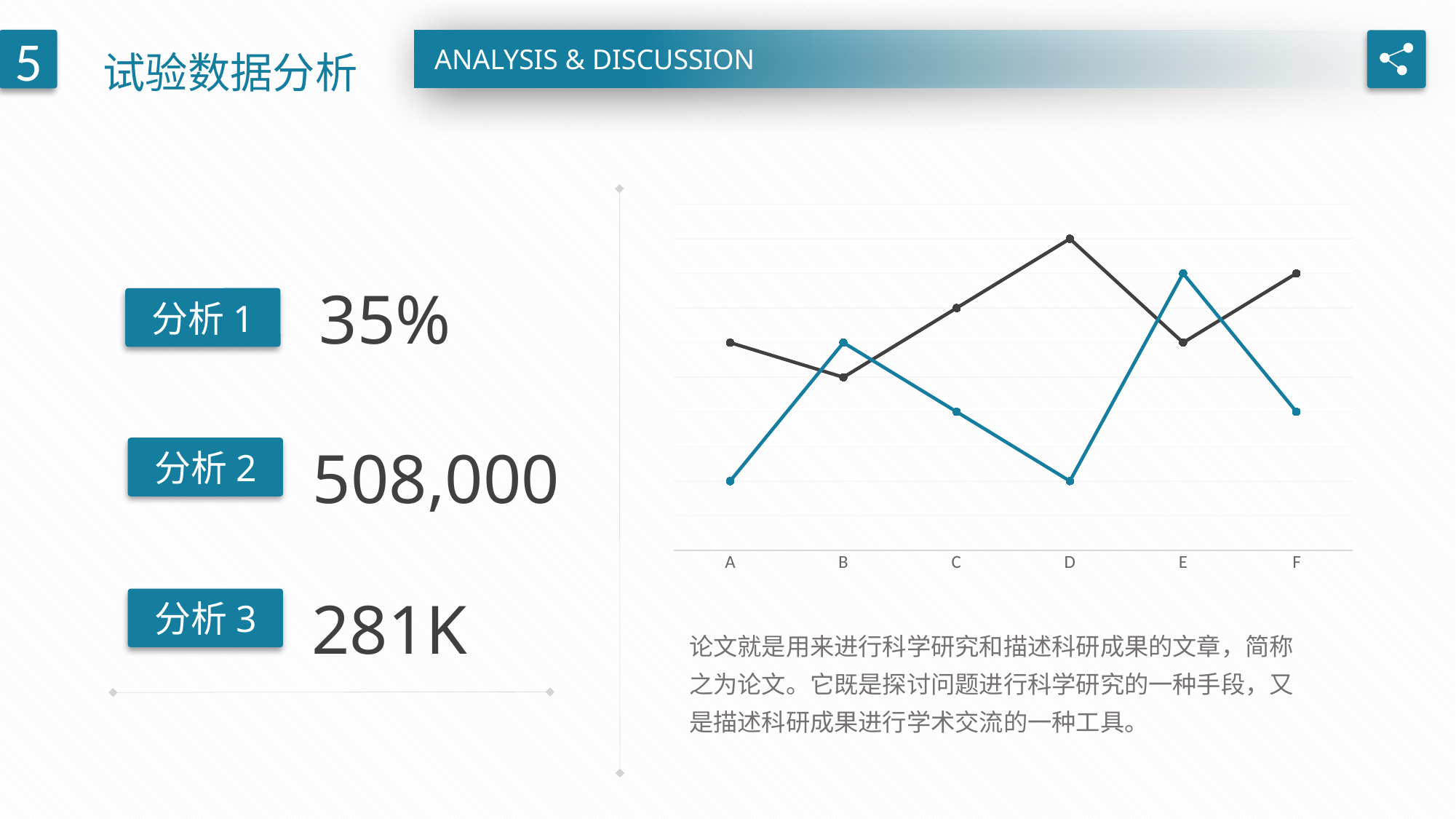
Does the teal line rise or fall from B to D? fall At category E, which line is higher, the black line or the teal line? teal line How many lines are plotted on the line chart? 2 At which category does the black line reach its lowest point? B What are the labels on the x axis of the line chart? A, B, C, D, E, F At which category does the black line reach its highest point? D What kind of chart is shown on the right of the slide? line chart Does the black line rise or fall from C to D? rise At category A, which line is higher, the black line or the teal line? black line How many categories are shown on the x axis of the line chart? 6 At which category does the teal line reach its highest point? E At category D, which line is higher, the black line or the teal line? black line